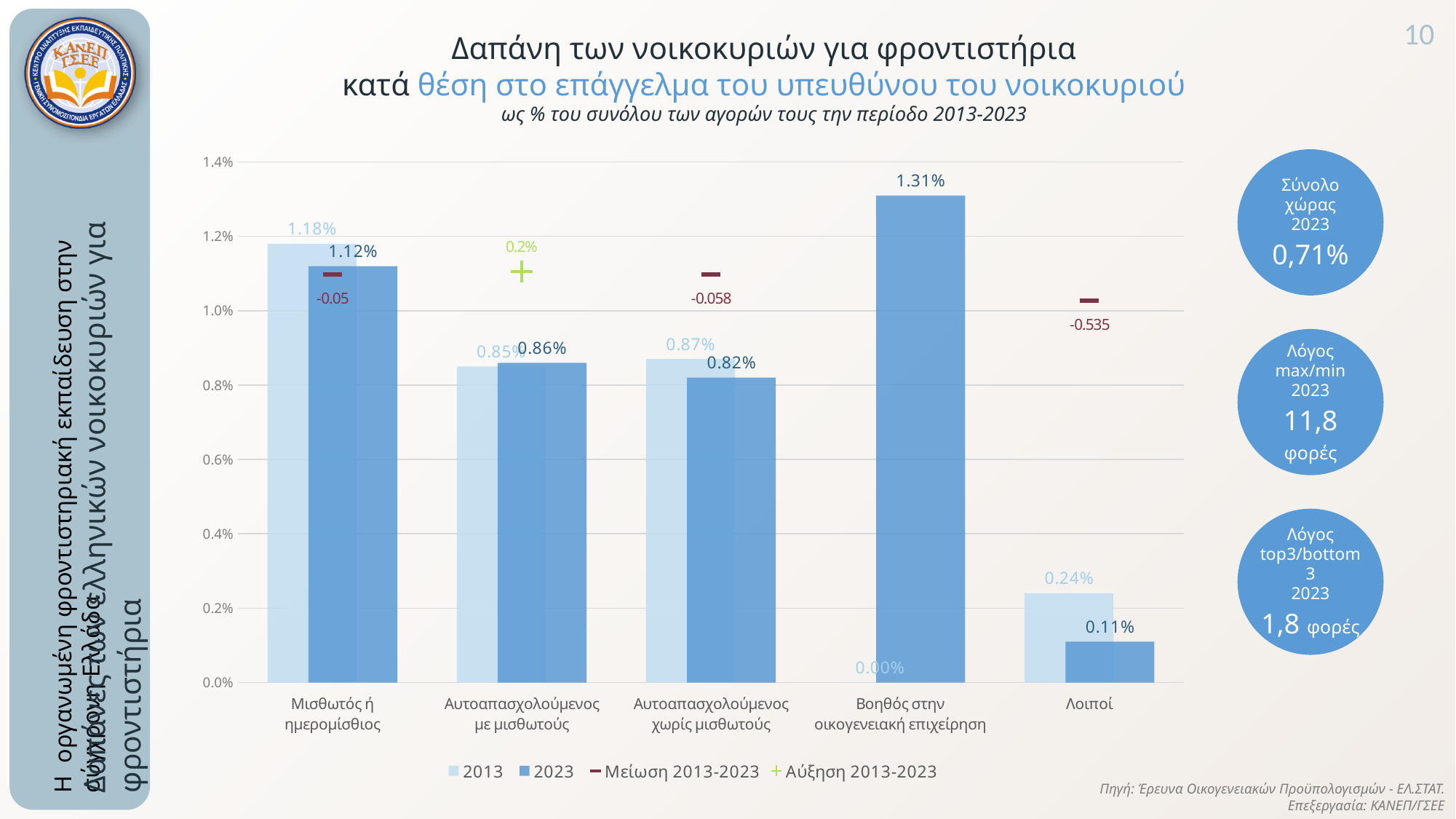
What is the difference between the 2013 and 2023 values for Λοιποί? 0.13% What is the 2013 value for Αυτοαπασχολούμενος χωρίς μισθωτούς? 0.87% Which category has the highest 2023 value? Βοηθός στην οικογενειακή επιχείρηση What is the 2023 value for Βοηθός στην οικογενειακή επιχείρηση? 1.31% Which category has the lowest 2013 value? Βοηθός στην οικογενειακή επιχείρηση Which is larger for Μισθωτός ή ημερομίσθιος: the 2013 value or the 2023 value? 2013 Is the 2023 value for Αυτοαπασχολούμενος με μισθωτούς greater or less than 0.8%? greater How many categories are shown on the x axis? 5 How many entries does the legend list? 4 What kind of chart is shown on the slide? Bar chart What is the 2013 value for Μισθωτός ή ημερομίσθιος? 1.18% What is the 2023 value for Λοιποί? 0.11%